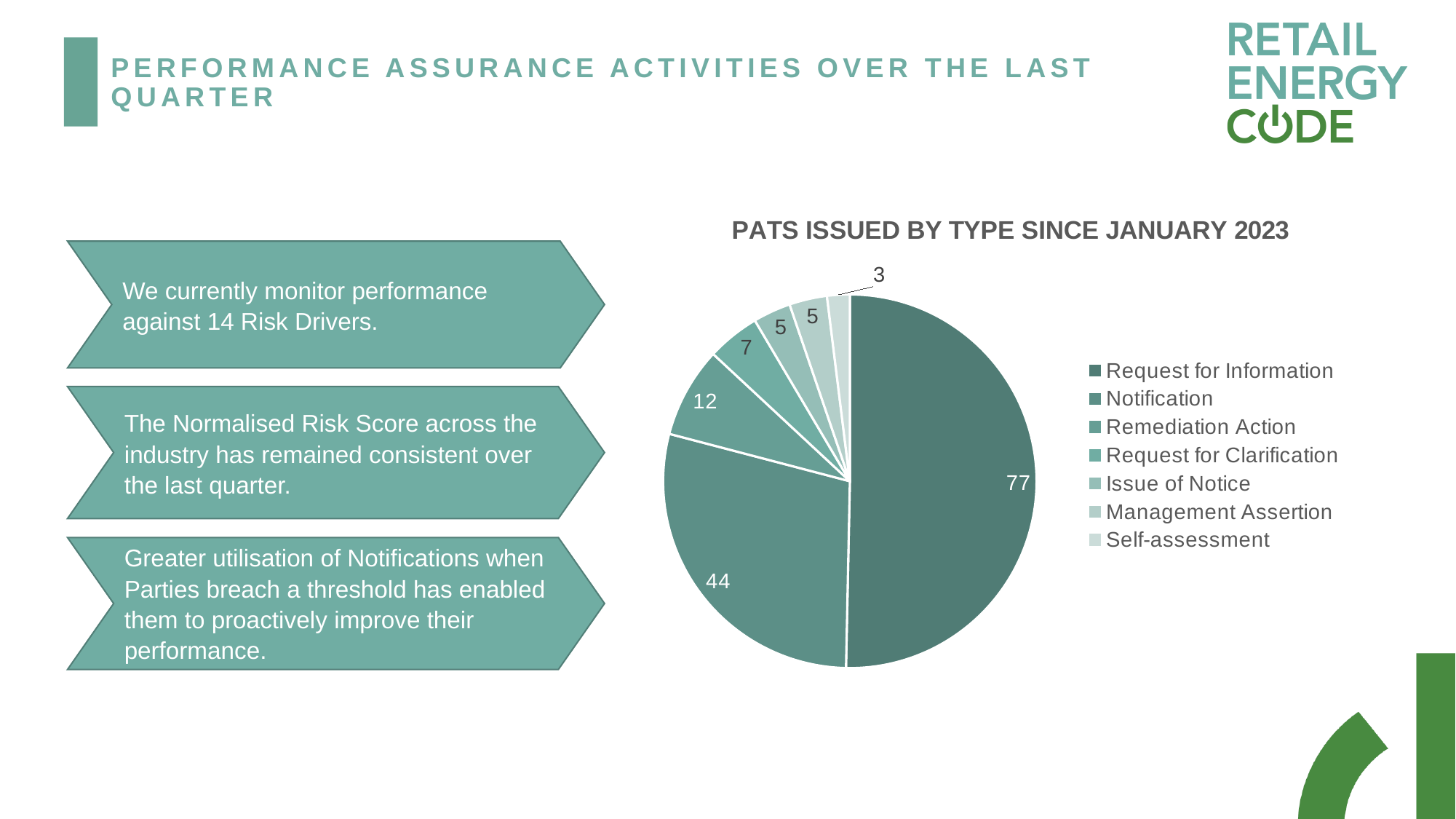
How many PATs were issued as Remediation Action? 12 How many PATs were issued as Self-assessment? 3 Which PAT type has the largest slice of the pie? Request for Information Which is larger, Remediation Action or Request for Clarification? Remediation Action How many PAT types does the legend list? 7 What type of chart is shown on the slide? Pie chart How many PATs were issued as Request for Clarification? 7 Which PAT type has the smallest slice of the pie? Self-assessment What is the title of the chart? PATS ISSUED BY TYPE SINCE JANUARY 2023 How many PATs were issued as Notification? 44 What is the difference between the number of Request for Information PATs and Notification PATs? 33 How many PATs were issued as Request for Information? 77